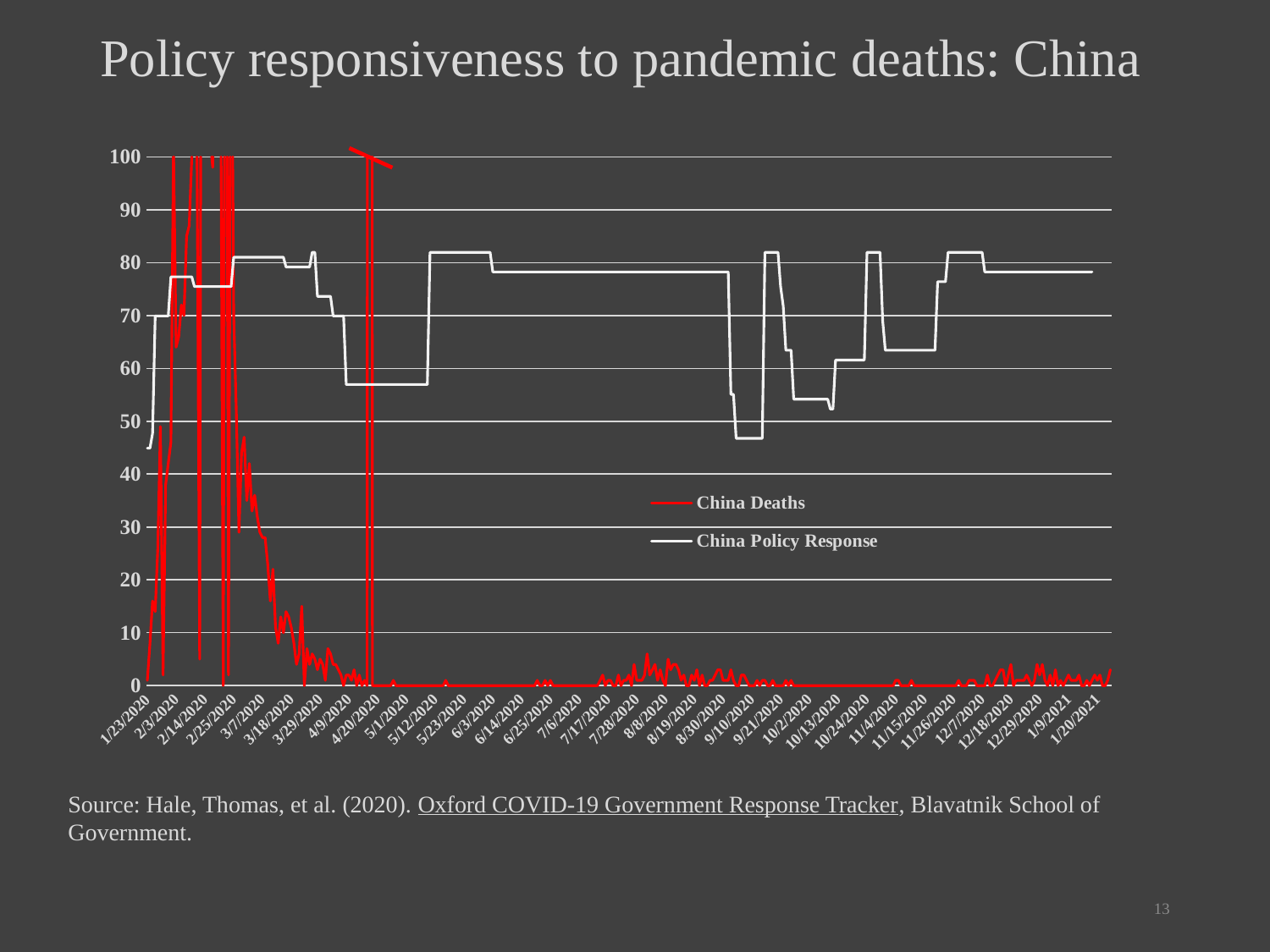
What colour is the China Policy Response line? white What are the two series named in the legend? China Deaths and China Policy Response Is the value of China Policy Response on 9/10/2020 greater or less than 50? less How many series does the legend list? 2 On 6/3/2020, which series has the higher value, China Deaths or China Policy Response? China Policy Response What kind of chart is shown on the slide? line chart Is the value of China Policy Response on 6/3/2020 greater or less than 70? greater Is the value of China Deaths on 6/3/2020 greater or less than 10? less Does the China Deaths line generally rise or fall between 3/7/2020 and 4/9/2020? fall